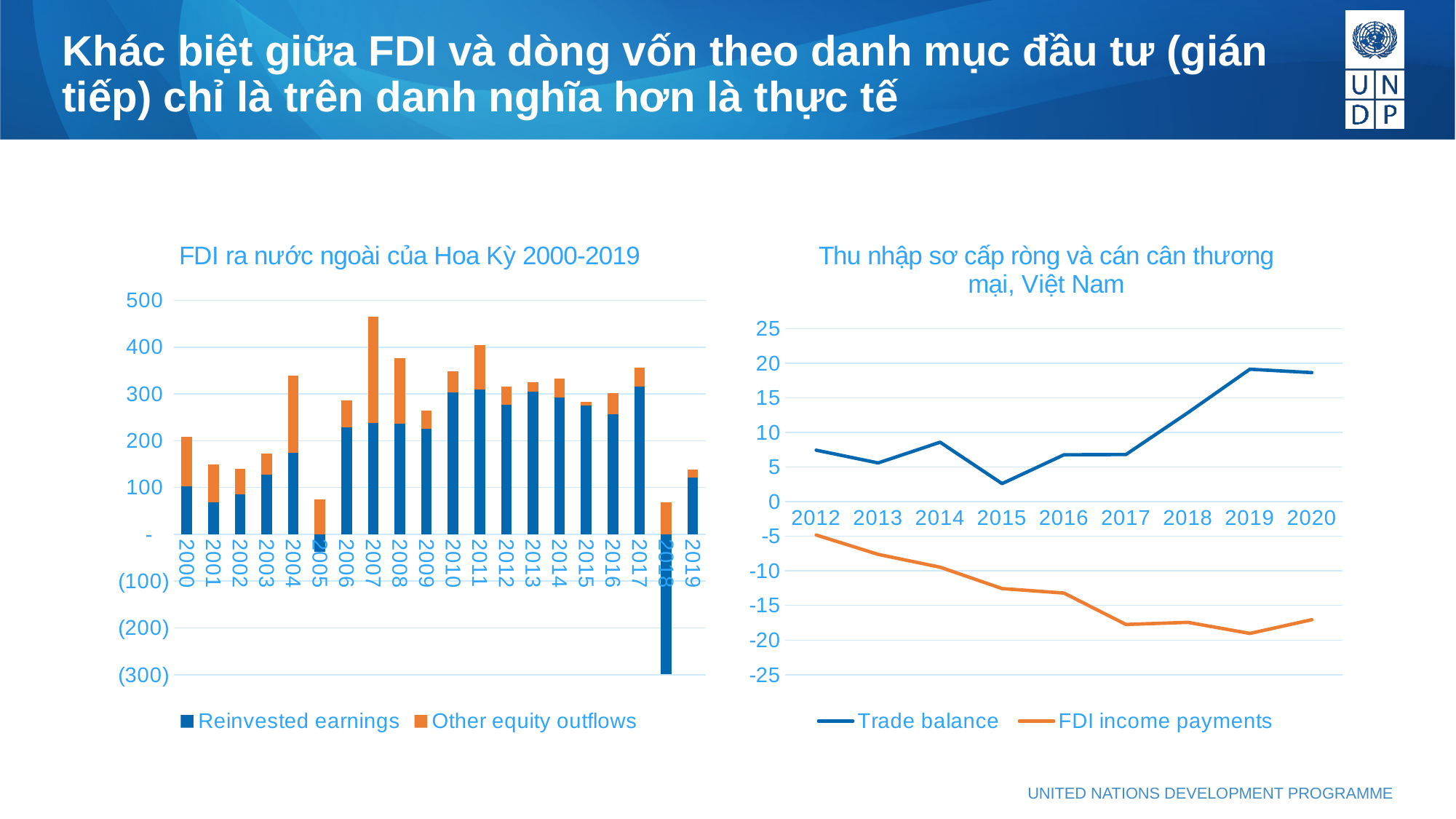
What kind of chart is the left chart titled 'FDI ra nước ngoài của Hoa Kỳ 2000-2019'? Stacked bar chart In the right chart 'Thu nhập sơ cấp ròng và cán cân thương mại, Việt Nam', which year has the lowest Trade balance? 2015 In the left chart 'FDI ra nước ngoài của Hoa Kỳ 2000-2019', is the Reinvested earnings value for 2018 greater or less than (200)? less What kind of chart is the right chart titled 'Thu nhập sơ cấp ròng và cán cân thương mại, Việt Nam'? Line chart In the left chart 'FDI ra nước ngoài của Hoa Kỳ 2000-2019', which year has the tallest stacked bar? 2007 In the right chart 'Thu nhập sơ cấp ròng và cán cân thương mại, Việt Nam', how many years are shown on the x axis? 9 In the right chart 'Thu nhập sơ cấp ròng và cán cân thương mại, Việt Nam', which series is drawn in orange? FDI income payments In the left chart 'FDI ra nước ngoài của Hoa Kỳ 2000-2019', how many years are shown on the x axis? 20 In the right chart 'Thu nhập sơ cấp ròng và cán cân thương mại, Việt Nam', is the Trade balance for 2019 greater or less than 15? greater How many series does the legend of the left chart 'FDI ra nước ngoài của Hoa Kỳ 2000-2019' list? 2 In the left chart 'FDI ra nước ngoài của Hoa Kỳ 2000-2019', is the total for 2007 greater or less than 400? greater In the right chart 'Thu nhập sơ cấp ròng và cán cân thương mại, Việt Nam', does the FDI income payments line generally rise or fall from 2012 to 2020? Fall